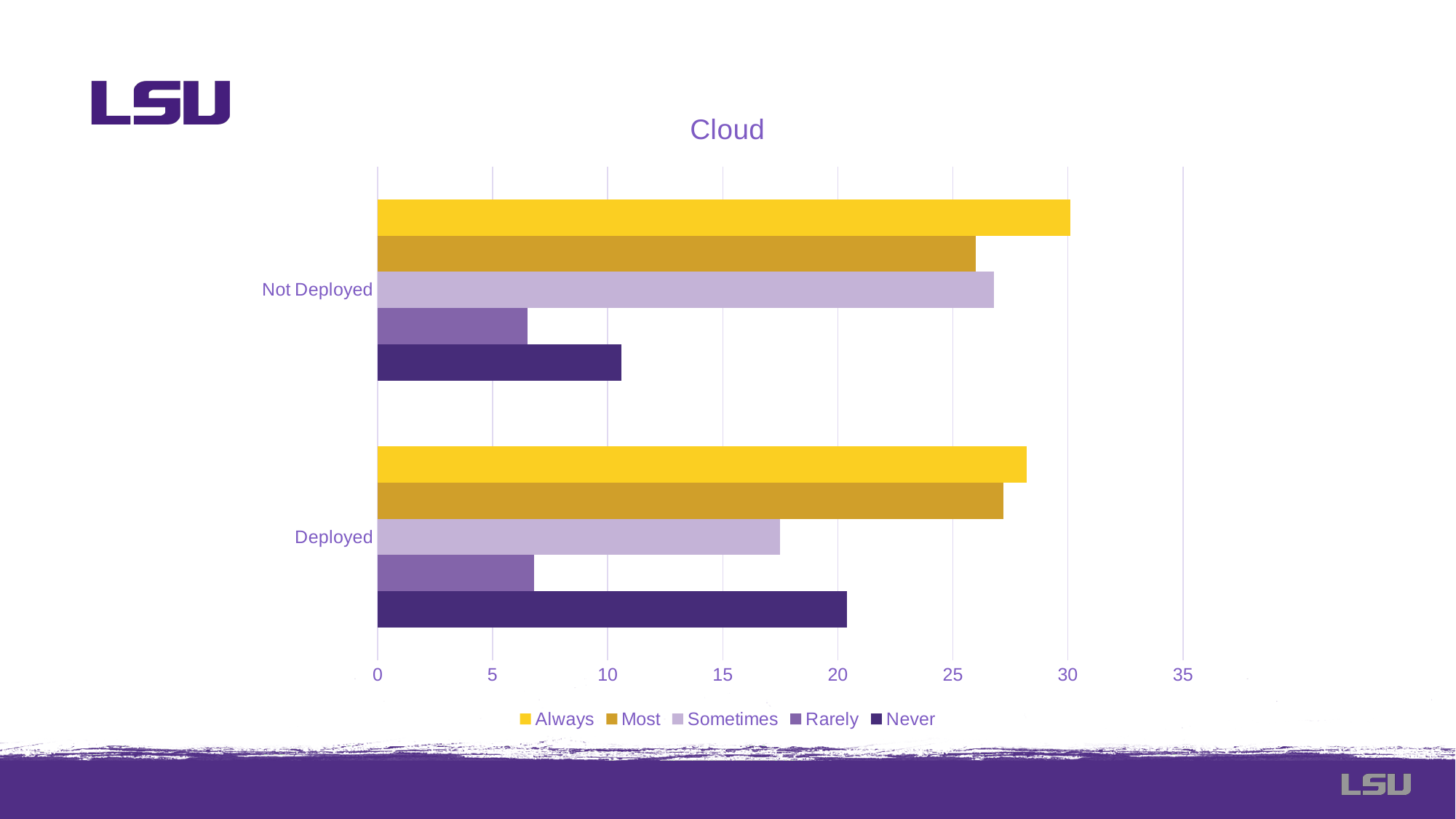
Is the value for Sometimes in the Deployed category greater or less than 15? greater Is the value for Never in the Not Deployed category greater or less than 15? less What is the title of the chart? Cloud Which series has the lowest value for Not Deployed? Rarely Which series has the lowest value for Deployed? Rarely How many series does the legend list? 5 Which series has the highest value for Not Deployed? Always What type of chart is shown on the slide? bar chart Which is larger: the Never value for Deployed or the Never value for Not Deployed? Deployed How many categories are shown on the vertical axis? 2 Which is larger: the Sometimes value for Not Deployed or the Sometimes value for Deployed? Not Deployed Is the value for Never in the Deployed category greater or less than 15? greater